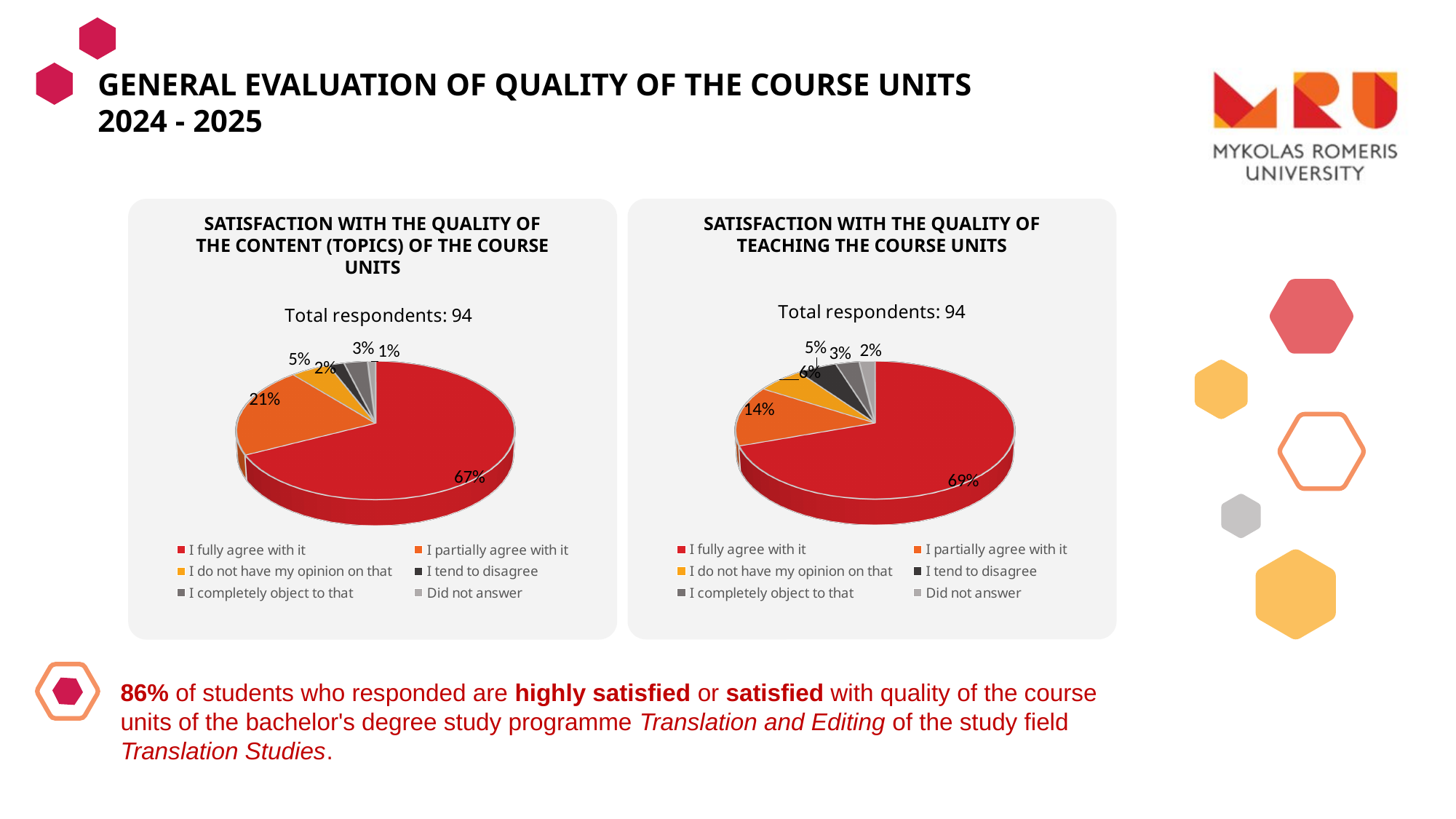
In the right chart (teaching the course units), what percentage of respondents chose "I partially agree with it"? 14% What is the difference between the "I partially agree with it" shares in the left chart (content) and the right chart (teaching)? 7 percentage points How many response categories does the legend of the left chart (content of the course units) list? 6 In the chart titled "Satisfaction with the quality of the content (topics) of the course units", what percentage of respondents chose "I fully agree with it"? 67% In the left chart (content of the course units), what percentage of respondents chose "I partially agree with it"? 21% In the left chart (content of the course units), which response category has the smallest share? Did not answer How many total respondents are reported for the chart titled "Satisfaction with the quality of the content (topics) of the course units"? 94 In the right chart (teaching the course units), what percentage of respondents chose "I do not have my opinion on that"? 6% Which chart has the larger share for "I fully agree with it": the content chart or the teaching chart? The teaching chart In the chart titled "Satisfaction with the quality of teaching the course units", what percentage of respondents chose "I fully agree with it"? 69% In the left chart (content of the course units), which response category has the largest share? I fully agree with it What type of chart is used in the chart titled "Satisfaction with the quality of teaching the course units"? Pie chart